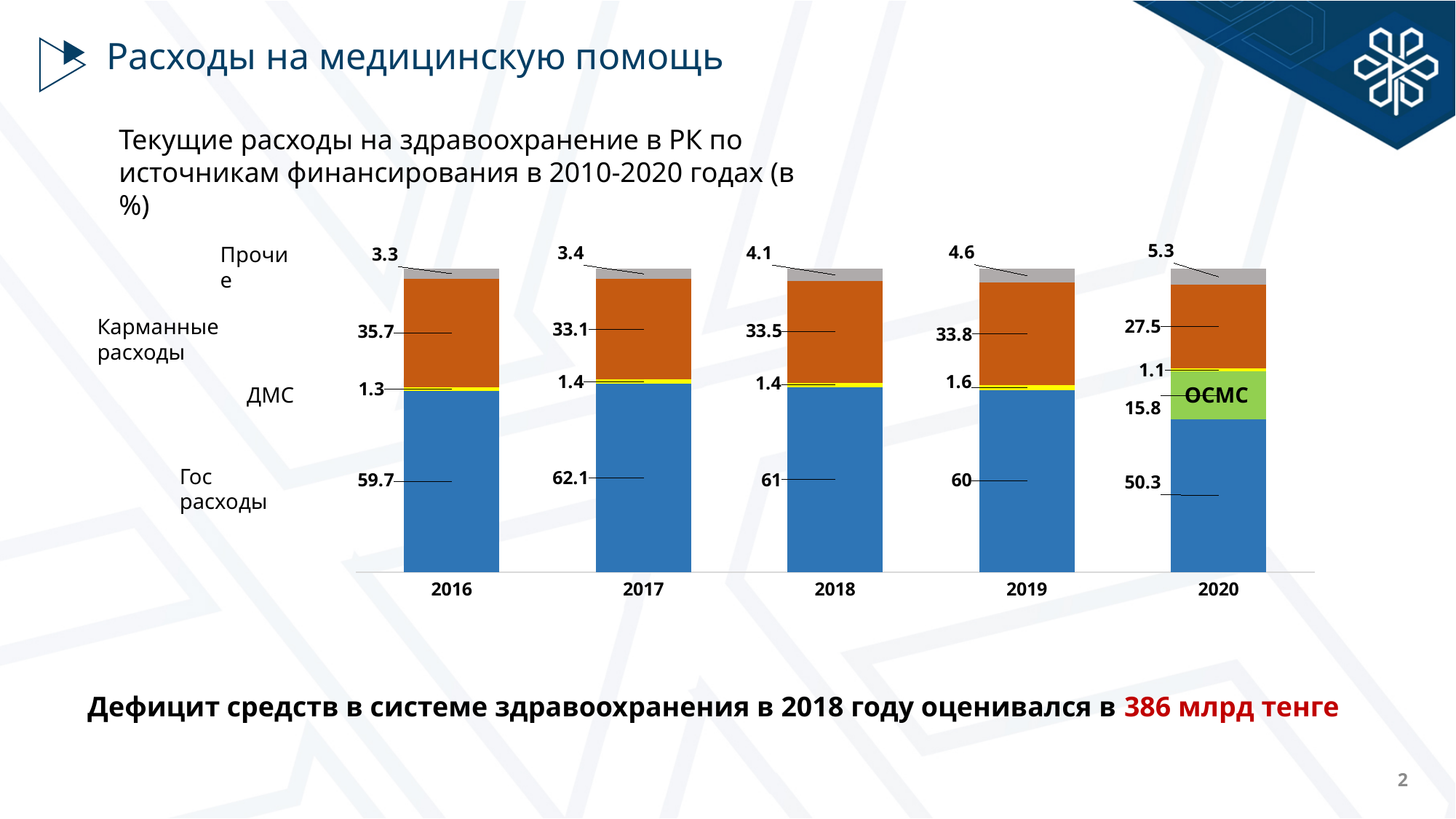
What is the difference between Гос расходы in 2017 and in 2020? 11.8 Which is larger: Карманные расходы in 2016 or in 2019? 2016 How many years are shown on the x axis? 5 In which year is Прочие the lowest? 2016 What is the value of ОСМС in 2020? 15.8 What kind of chart is shown on the slide? Stacked bar chart In which year is Гос расходы the highest? 2017 Does the value of Прочие rise or fall from 2016 to 2020? Rises What is the total of the stacked bar for 2020? 100 What is the value of Гос расходы for 2017? 62.1 What is the value of ДМС for 2019? 1.6 What is the value of Карманные расходы for 2020? 27.5